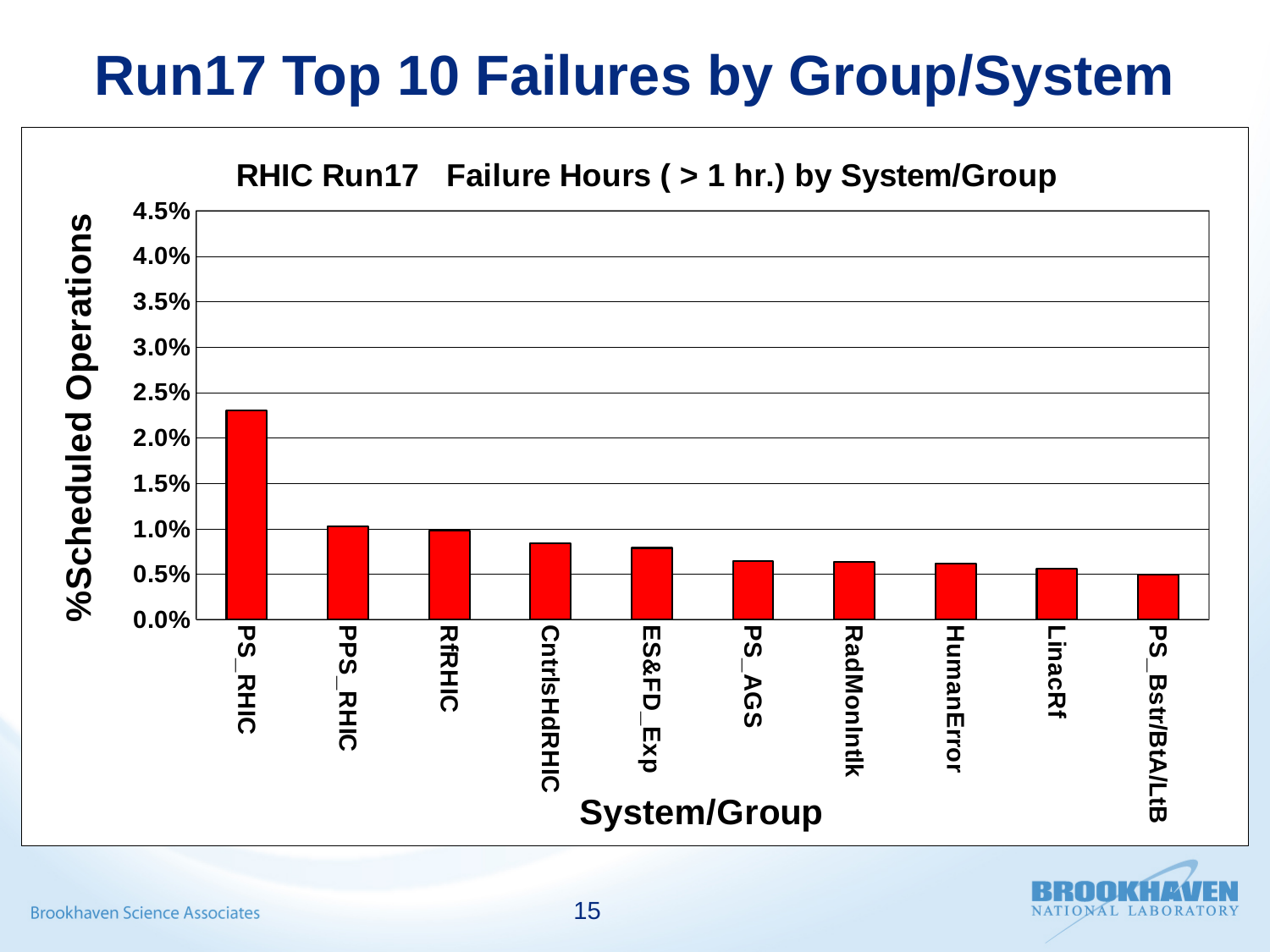
Is the value for PS_RHIC greater or less than 2.0%? greater Which system/group has the highest percentage of scheduled operations lost to failures? PS_RHIC Which has a larger value, CntrlsHdRHIC or PS_AGS? CntrlsHdRHIC How many system/group categories are plotted in the chart? 10 Is the value for ES&FD_Exp greater or less than 0.5%? greater Is the value for HumanError greater or less than 1.0%? less Do the bar values rise or fall moving from left to right along the x axis? fall What kind of chart is shown on the slide? bar chart Which has a larger value, PS_RHIC or PPS_RHIC? PS_RHIC What is the title of the chart? RHIC Run17 Failure Hours ( > 1 hr.) by System/Group